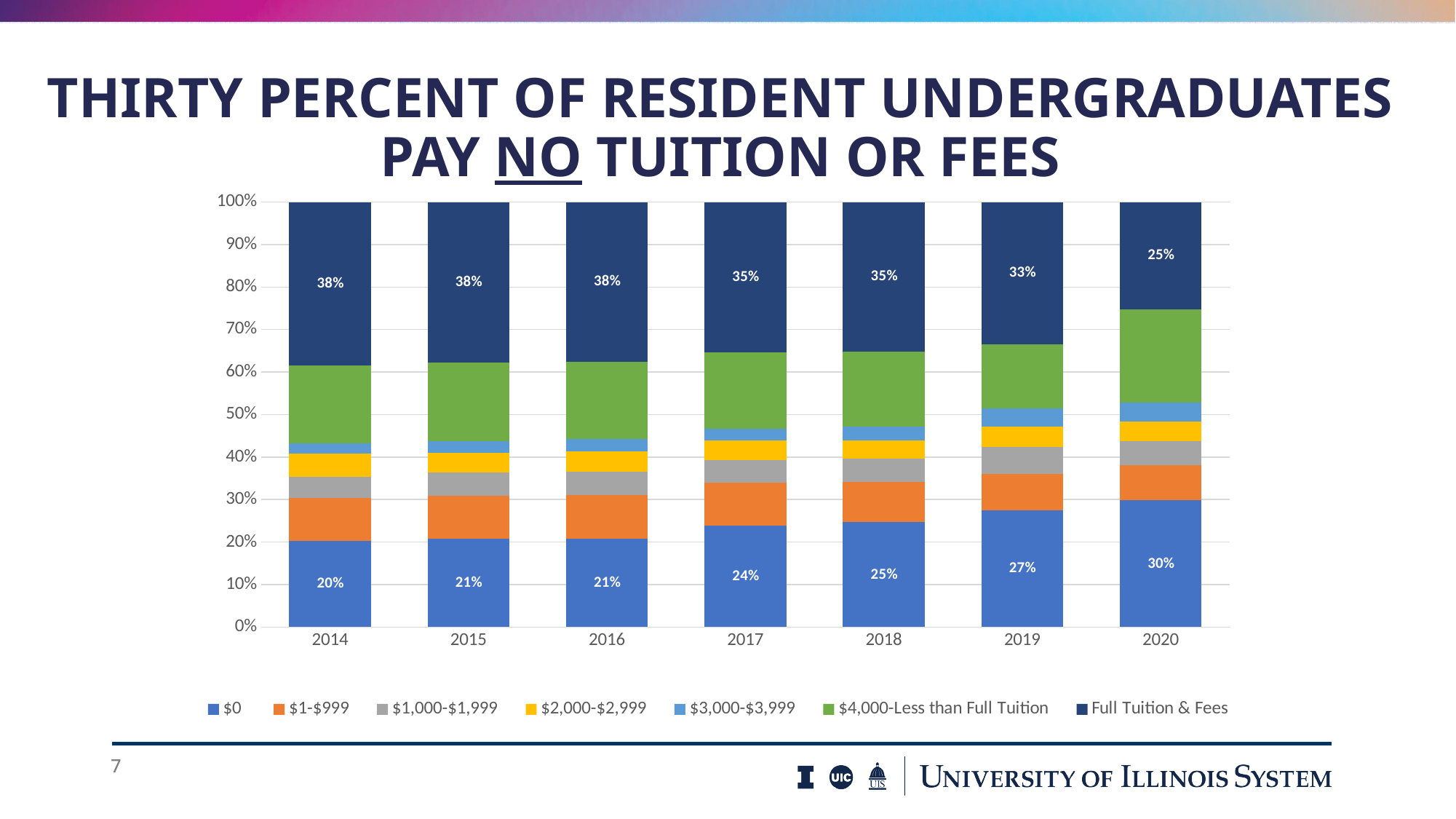
By how many percentage points did the $0 share increase from 2014 to 2020? 10 percentage points In 2018, which is larger: the $0 share or the Full Tuition & Fees share? Full Tuition & Fees What is the $0 share shown for 2019? 27% How many series does the legend list? 7 What percentage of resident undergraduates paid $0 in 2014? 20% Which year has the highest $0 share? 2020 What kind of chart is shown on the slide? Stacked bar chart Which year has the lowest Full Tuition & Fees share? 2020 What is the Full Tuition & Fees share in 2017? 35% How many years are shown on the x axis? 7 Does the $0 share rise or fall from 2014 to 2020? Rise What is the Full Tuition & Fees share in 2020? 25%